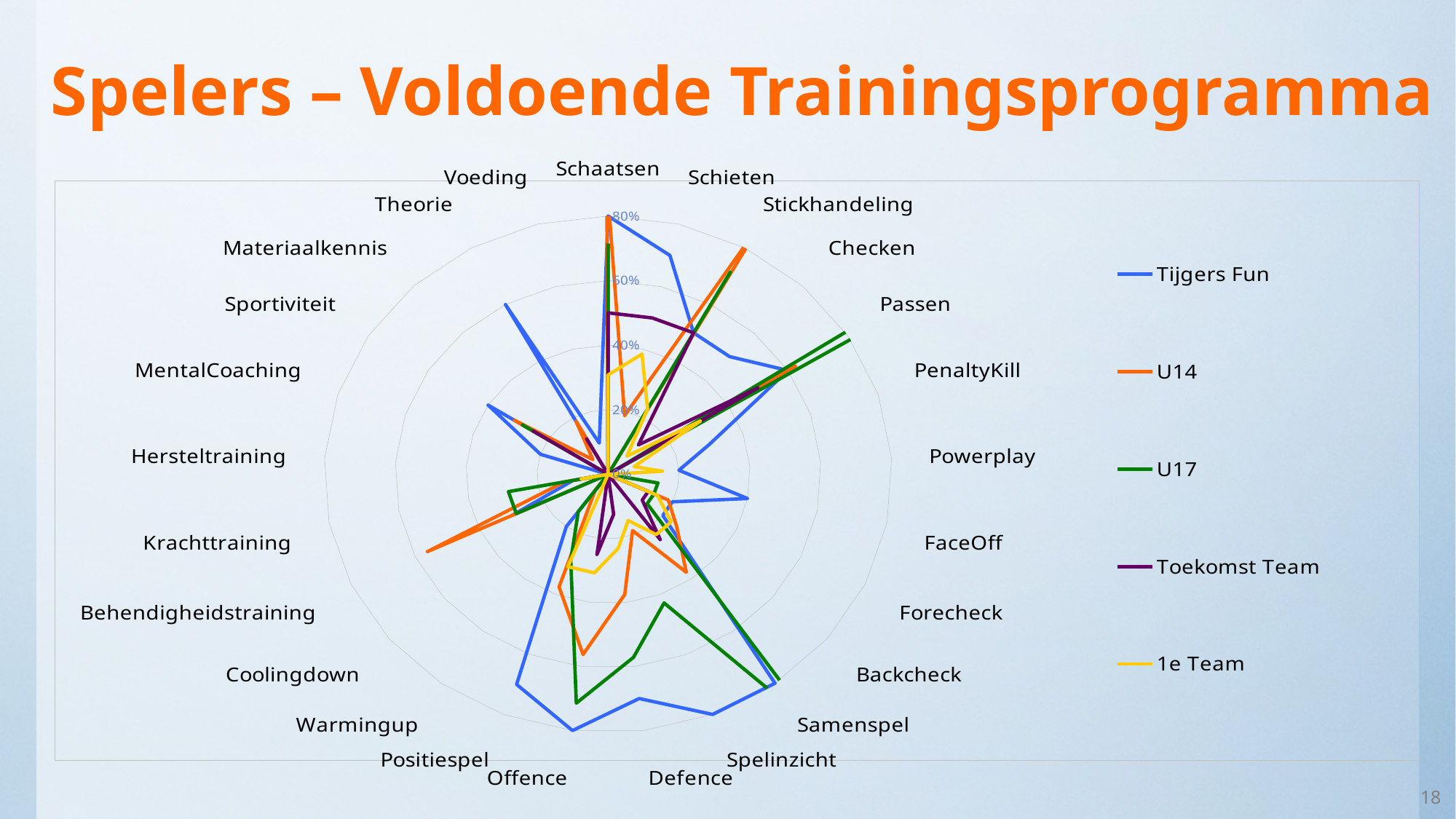
Is the value for U17 at Krachttraining greater or less than 40%? less What kind of chart is shown on the slide? radar chart Which series has the larger value at Schaatsen, Tijgers Fun or Toekomst Team? Tijgers Fun Is the value for U14 at Checken greater or less than 60%? less Is the value for Tijgers Fun at Schaatsen greater or less than 60%? greater What is the title of the slide containing the chart? Spelers – Voldoende Trainingsprogramma How many series does the legend list? 5 How many categories are plotted around the radar chart? 25 What colour is the U17 series drawn in? green